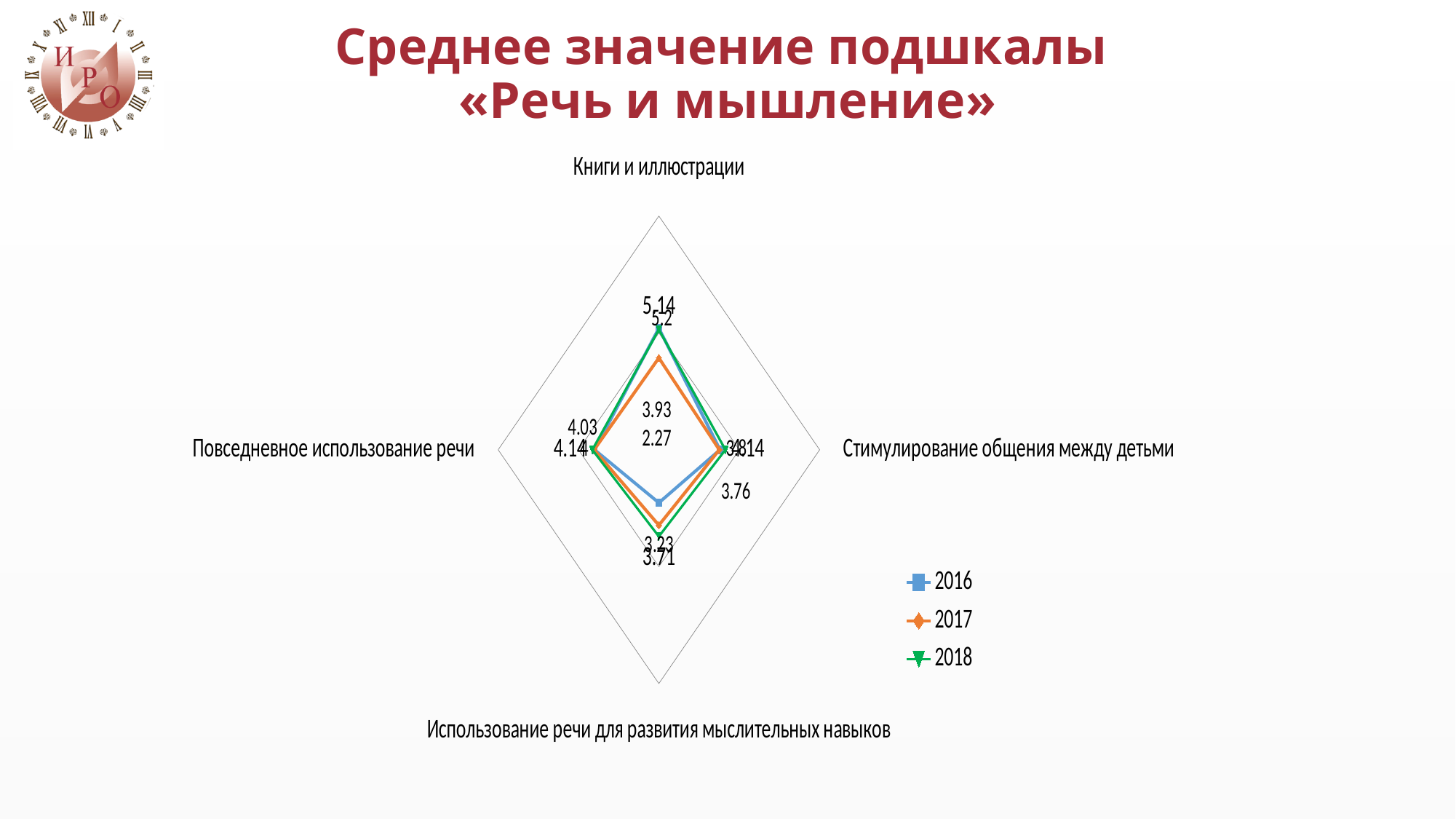
For the category Книги и иллюстрации, which is larger: the 2018 value or the 2017 value? 2018 For the 2016 series, which category has the lowest value? Использование речи для развития мыслительных навыков How many series does the legend list? 3 Which years are listed in the legend? 2016, 2017, 2018 For the 2017 series, which category has the highest value? Повседневное использование речи For the 2018 series, which category has the highest value? Книги и иллюстрации What is the title of the slide? Среднее значение подшкалы «Речь и мышление» What kind of chart is shown on the slide? radar chart How many categories (axes) does the radar chart have? 4 For the category Использование речи для развития мыслительных навыков, which is larger: the 2018 value or the 2016 value? 2018